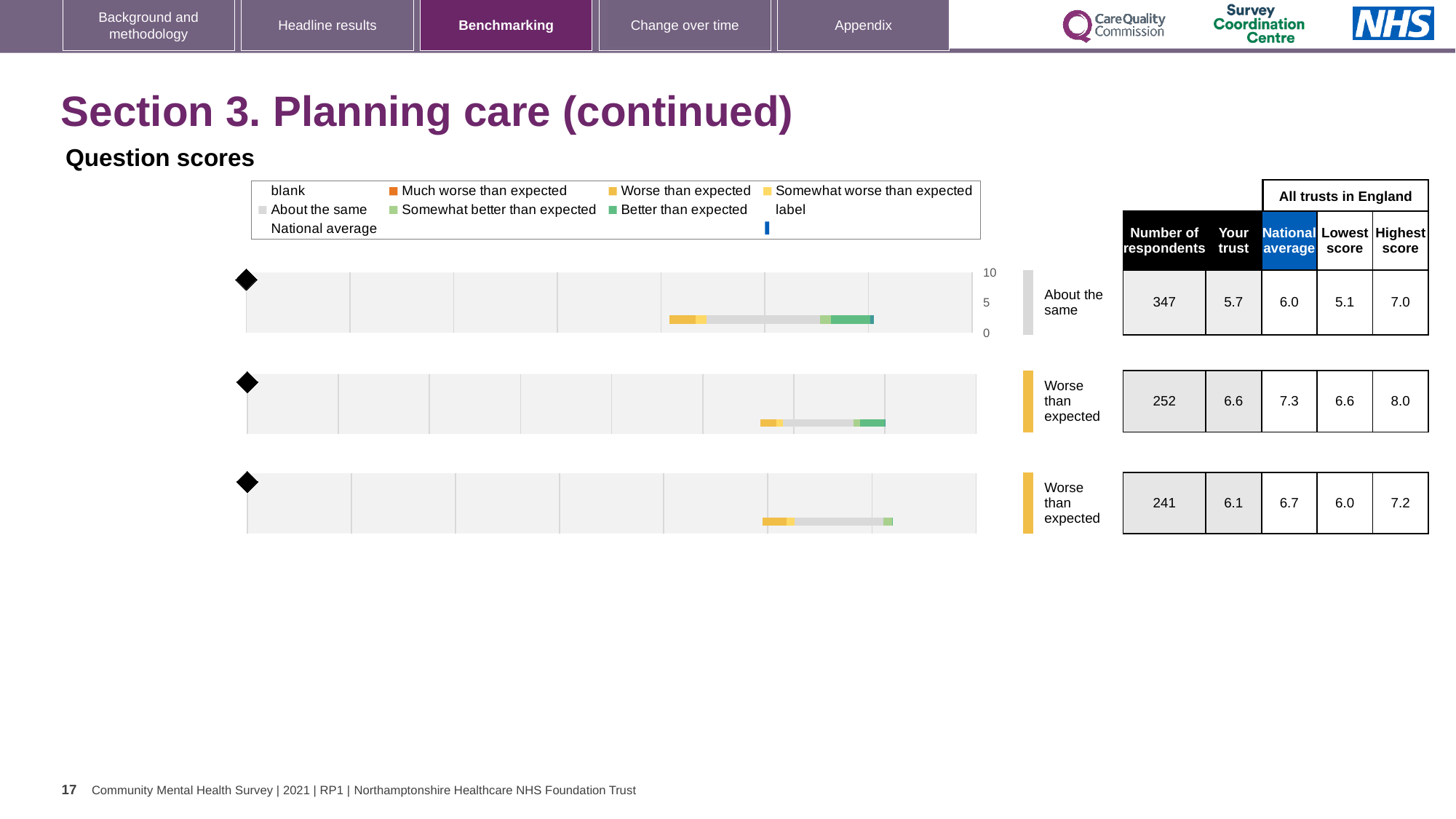
For the middle chart (the first 'Worse than expected' row), what is the difference between the national average and the 'Your trust' score? 0.7 In the top chart, is the 'Your trust' score greater or less than 5? greater For the bottom chart (the second 'Worse than expected' row), what is the lowest score among all trusts in England? 6.0 For the bottom chart (the second 'Worse than expected' row), what is the difference between the national average and the 'Your trust' score? 0.6 For the top chart (rated 'About the same'), what is the national average score? 6.0 Which of the three charts has the highest 'Your trust' score? The middle chart (6.6) How many question score charts (rows) are shown on the slide? 3 For the middle chart (the first 'Worse than expected' row), what is the highest score among all trusts in England? 8.0 Which of the three charts has the fewest respondents? The bottom chart (241) For the top chart (rated 'About the same'), what is the 'Your trust' score? 5.7 What kind of chart is used to show the question scores on this slide? Bar chart For the top chart (rated 'About the same'), how many respondents are there? 347